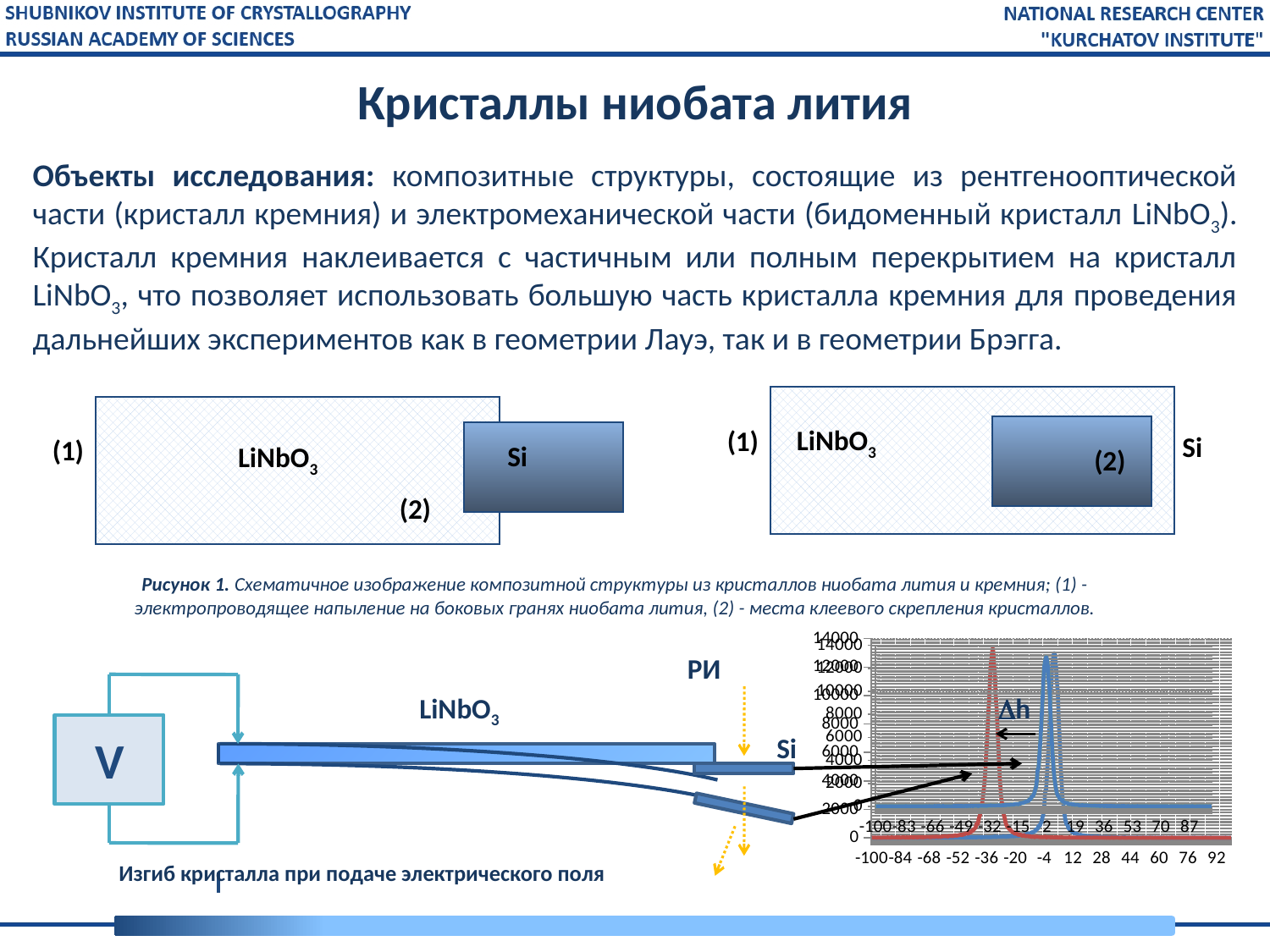
What kind of chart is shown in the bottom right of the slide? line chart In the chart at the bottom right, what is the leftmost value shown on the horizontal axis? -100 In the chart at the bottom right, which peak is located further to the left on the horizontal axis, the red dashed one or the blue one? the red dashed one In the chart at the bottom right, how many peaks (curves) are plotted? 2 In the chart at the bottom right, is the maximum of the red dashed peak greater or less than 10000? greater In the chart at the bottom right, what label is written between the two peaks? Δh In the chart at the bottom right, what is the highest value shown on the vertical axis? 14000 In the chart at the bottom right, is the maximum of the blue peak greater or less than 10000? greater